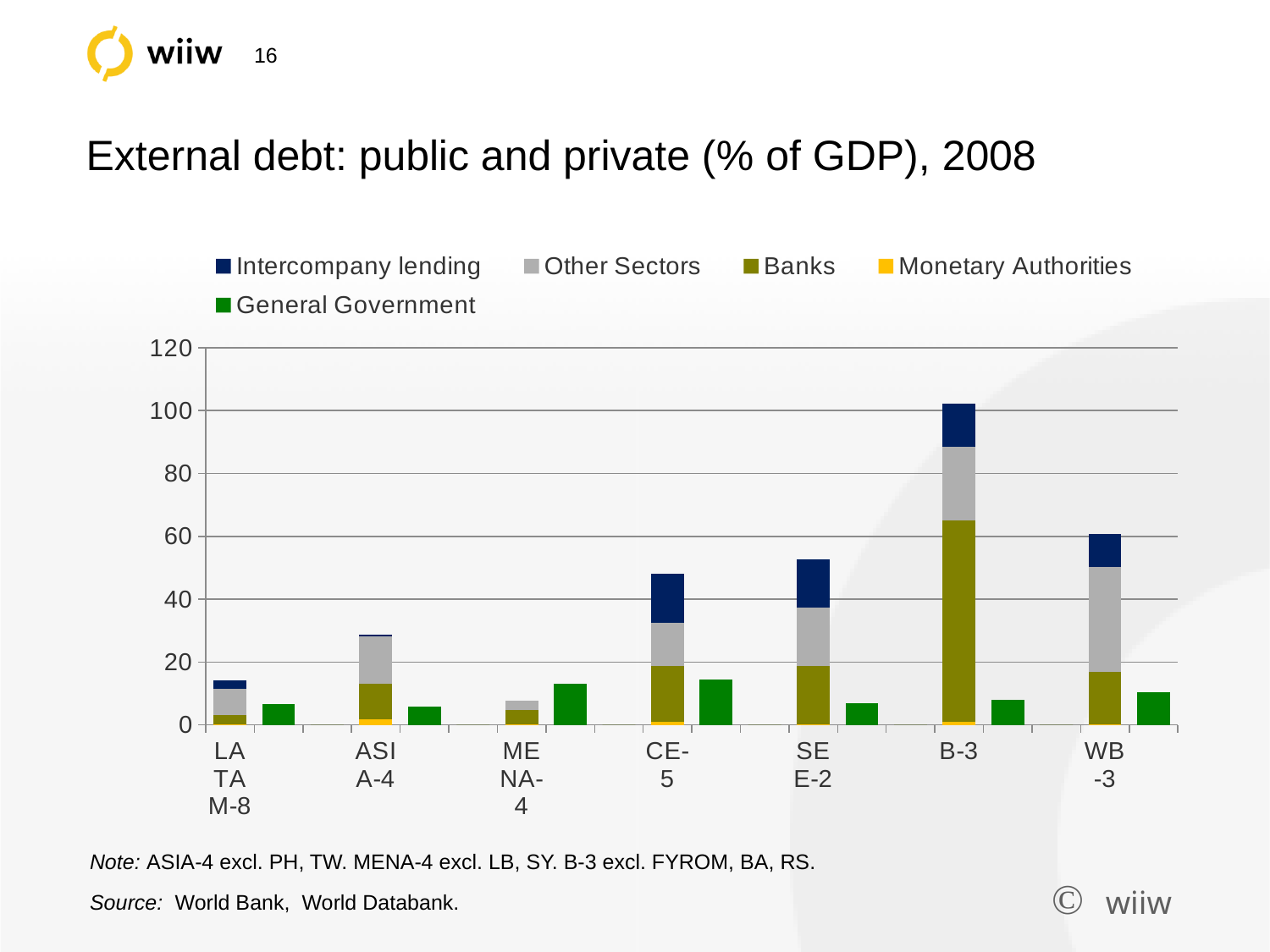
Is the total of the stacked bar for LATAM-8 greater or less than 20? less How many series does the legend list? 5 Which country group has the shortest stacked bar (private external debt)? MENA-4 Which has the larger General Government value, CE-5 or LATAM-8? CE-5 What is the title of the chart? External debt: public and private (% of GDP), 2008 Is the General Government value for B-3 greater or less than 20? less Is the total of the stacked bar for CE-5 greater or less than 60? less What kind of chart is shown on the slide? bar chart How many country groups are shown on the x axis? 7 Which has the larger stacked bar, B-3 or WB-3? B-3 Which country group has the tallest stacked bar (private external debt)? B-3